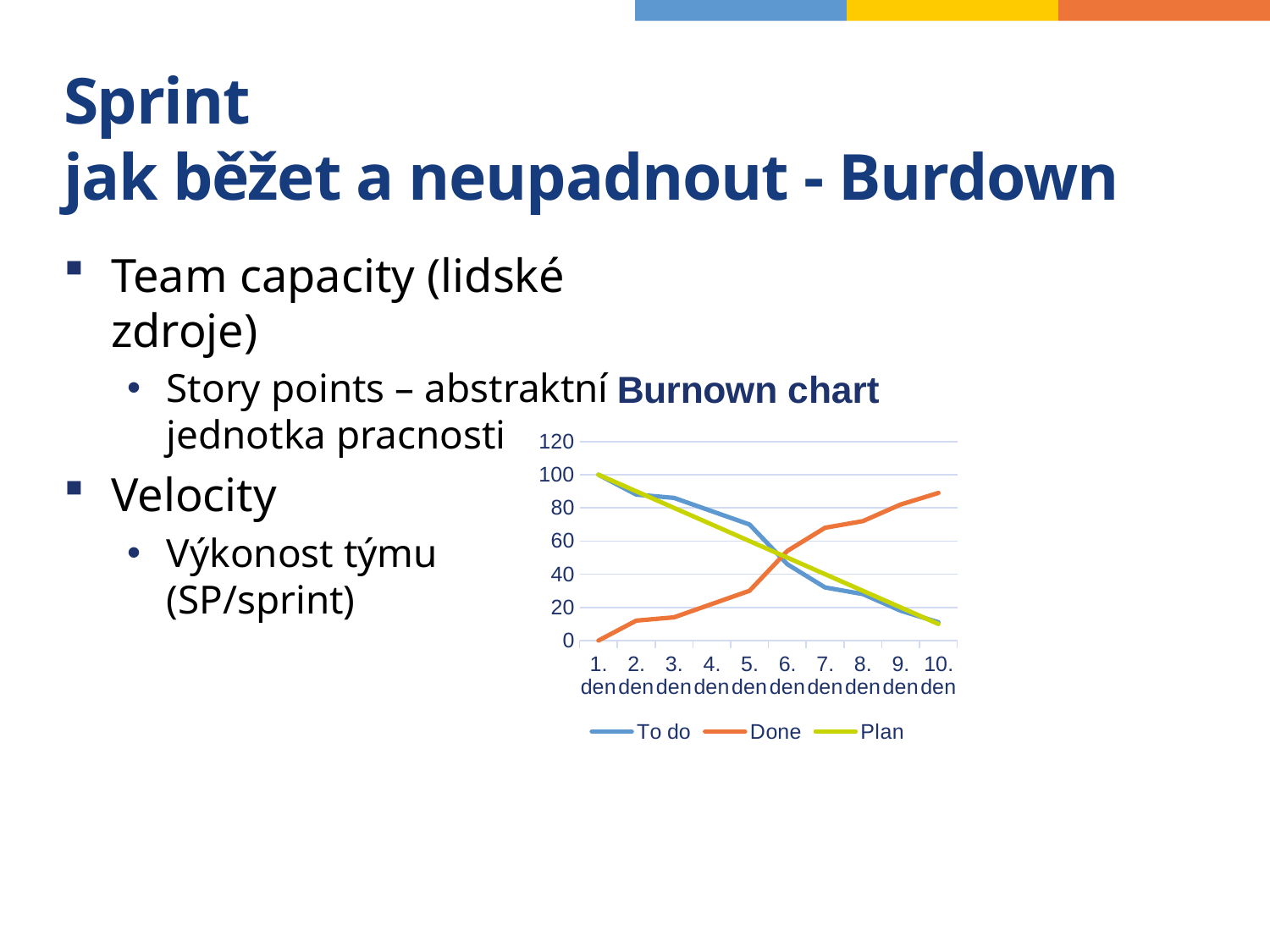
On 10. den, which series has the larger value in the Burnown chart, To do or Done? Done How many series does the legend of the Burnown chart list? 3 Does the To do series rise or fall from 1. den to 10. den in the Burnown chart? fall What is the value of the To do series on 1. den in the Burnown chart? 100 Is the value of the To do series on 10. den greater or less than 20 in the Burnown chart? less Does the Done series rise or fall from 1. den to 10. den in the Burnown chart? rise Is the value of the Done series on 10. den greater or less than 80 in the Burnown chart? greater What are the three series named in the legend of the Burnown chart? To do, Done, Plan Is the value of the To do series on 5. den greater or less than 60 in the Burnown chart? greater What is the value of the Done series on 1. den in the Burnown chart? 0 What kind of chart is the Burnown chart? line chart How many days (points) are shown on the x axis of the Burnown chart? 10